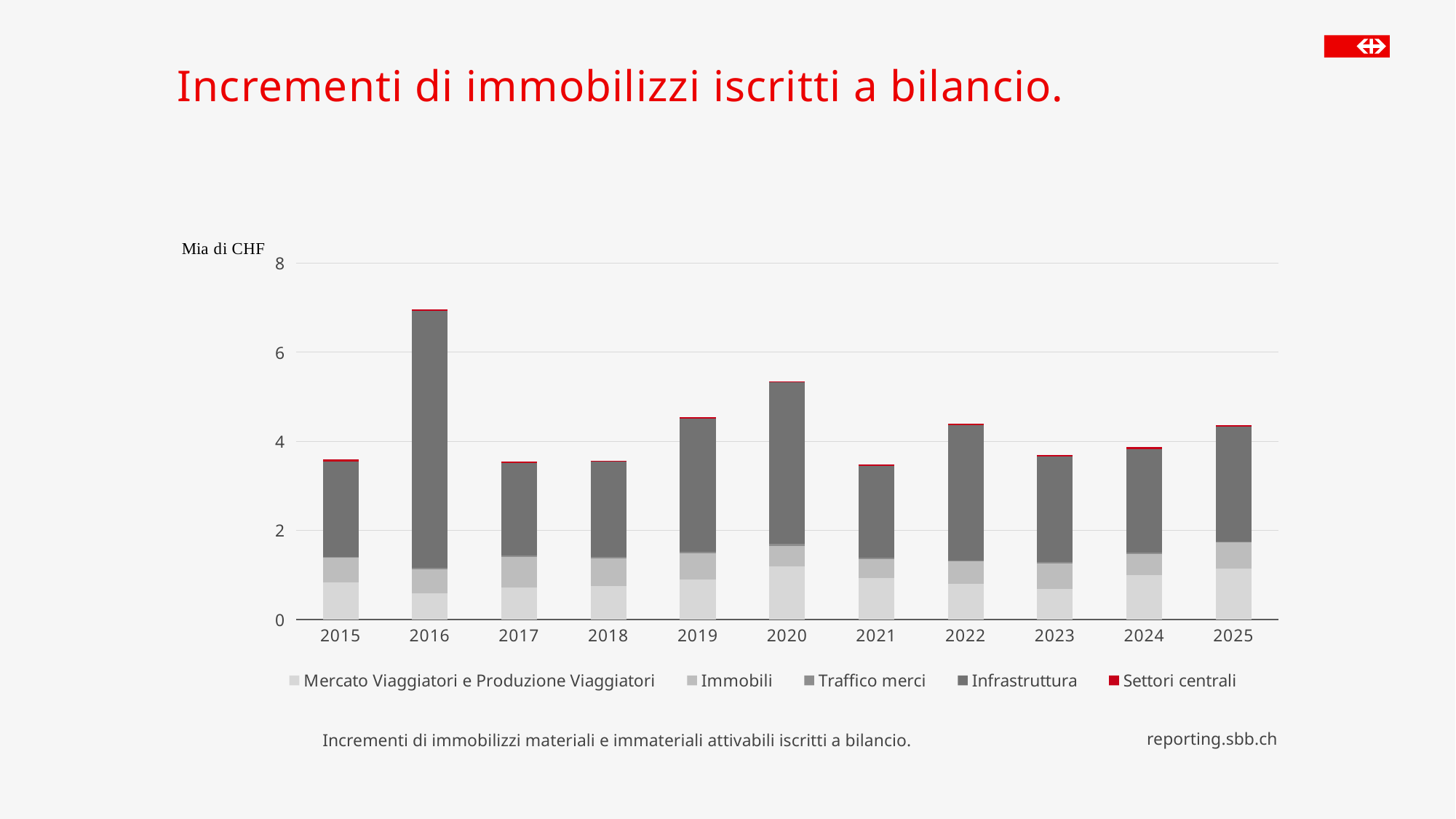
Which year has the larger total bar, 2016 or 2020? 2016 Is the total value for 2016 greater or less than 6? greater Is the total value for 2020 greater or less than 4? greater Is the total value for 2018 greater or less than 4? less Which series in the legend is shown in red? Settori centrali What unit is shown on the y axis of the chart? Mia di CHF Which year has the highest total bar in the chart? 2016 Which year has the larger total bar, 2019 or 2021? 2019 What kind of chart is shown on the slide? Stacked bar chart How many years are shown on the x axis of the chart? 11 How many series does the chart's legend list? 5